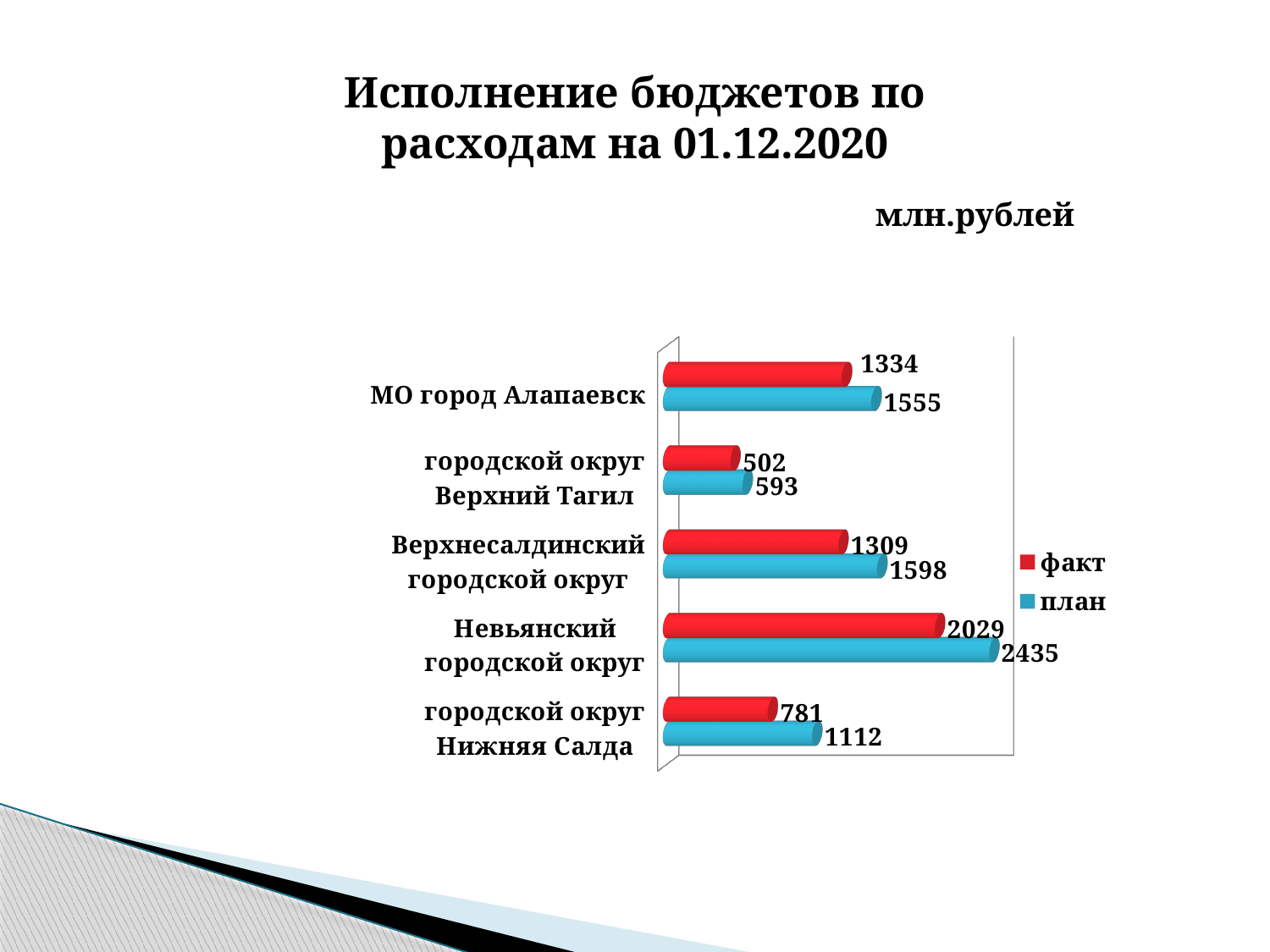
What is the difference between the план and факт values for Верхнесалдинский городской округ? 289 What is the план value for Невьянский городской округ? 2435 Which colour represents the план series? blue How many series does the legend list? 2 What is the difference between the план and факт values for городской округ Нижняя Салда? 331 What is the план value for городской округ Нижняя Салда? 1112 Which category has the lowest план value? городской округ Верхний Тагил What is the факт value for МО город Алапаевск? 1334 Which is larger, the факт value for МО город Алапаевск or the факт value for Верхнесалдинский городской округ? МО город Алапаевск What kind of chart is shown on the slide? bar chart How many categories are shown on the chart? 5 Which category has the highest факт value? Невьянский городской округ